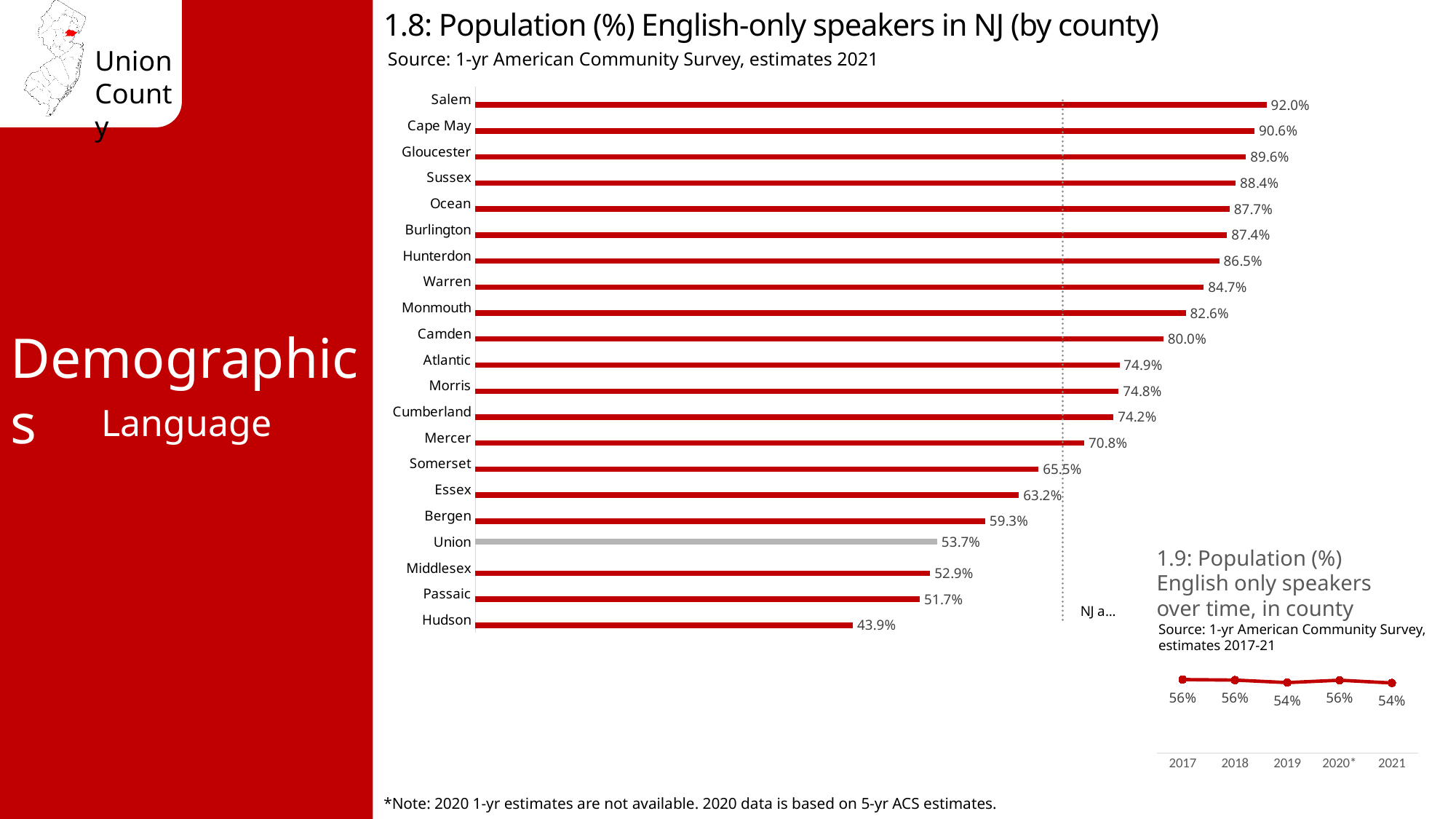
What kind of chart is chart 1.9 (English only speakers over time, in county)? Line chart In chart 1.8 (English-only speakers by county), which county has the highest value? Salem In chart 1.8 (English-only speakers by county), which county has the lowest value? Hudson In chart 1.8 (English-only speakers by county), what is the value for Camden? 80.0% In chart 1.8 (English-only speakers by county), which is larger, Bergen or Essex? Essex In chart 1.8 (English-only speakers by county), what is the value for Union? 53.7% In chart 1.8 (English-only speakers by county), how many counties are shown? 21 In chart 1.8 (English-only speakers by county), which bar is coloured grey instead of red? Union In chart 1.9 (English only speakers over time, in county), what is the value for 2019? 54% In chart 1.8 (English-only speakers by county), what is the difference between Salem and Hudson? 48.1% What kind of chart is chart 1.8 (English-only speakers by county)? Bar chart In chart 1.9 (English only speakers over time, in county), how many years are plotted? 5